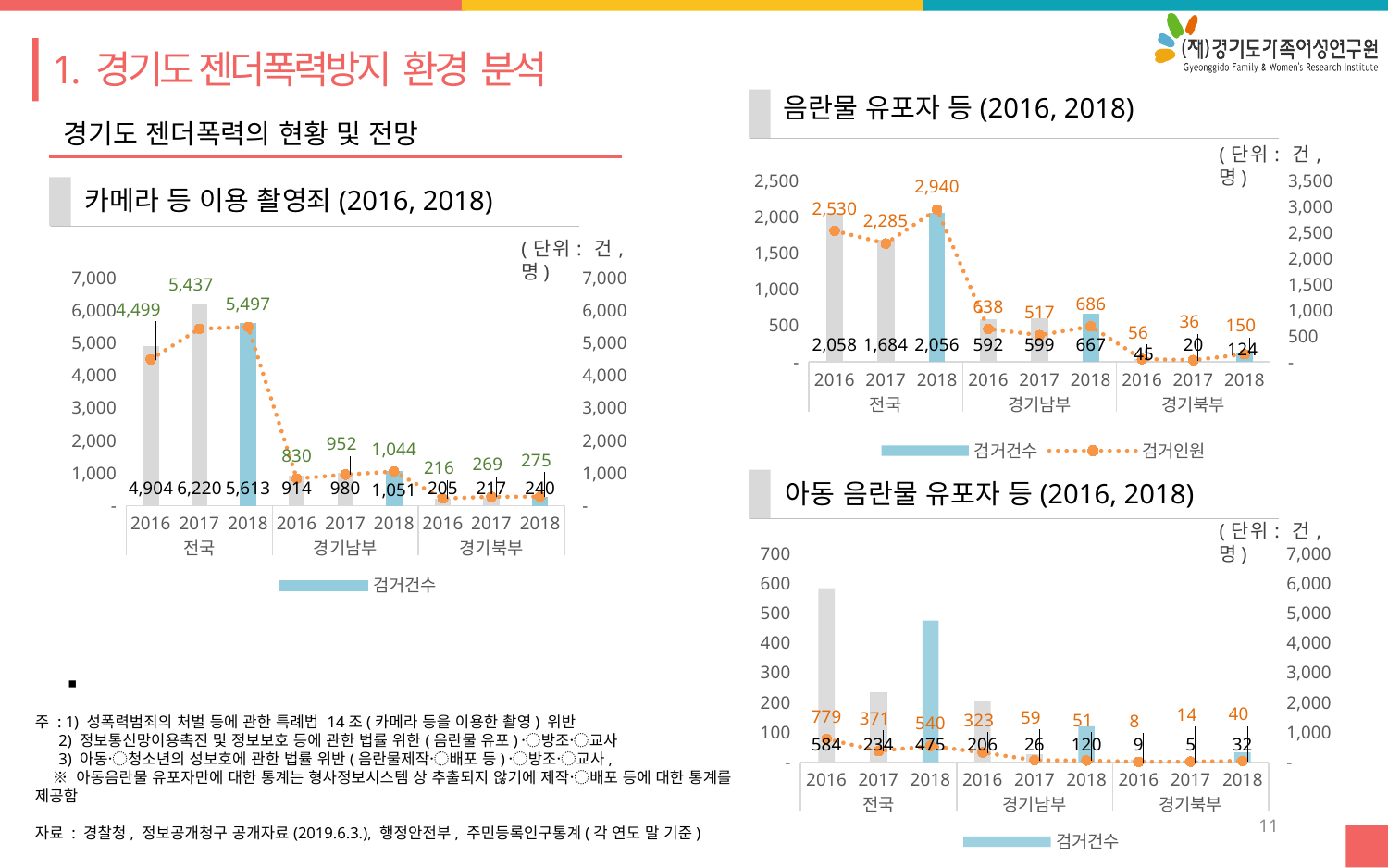
In the chart titled 음란물 유포자 등 (2016, 2018), how many series does the legend list? 2 In the chart titled 카메라 등 이용 촬영죄 (2016, 2018), which year has the highest 검거건수 bar for 전국? 2017 What kind of chart is the chart titled 아동 음란물 유포자 등 (2016, 2018)? Combined bar and line chart In the chart titled 카메라 등 이용 촬영죄 (2016, 2018), what is the 검거건수 bar value for 전국 in 2017? 6,220 In the chart titled 카메라 등 이용 촬영죄 (2016, 2018), what is the 검거건수 bar value for 경기북부 in 2018? 240 In the chart titled 카메라 등 이용 촬영죄 (2016, 2018), what is the difference between the 경기남부 검거건수 bars for 2018 and 2016? 137 In the chart titled 음란물 유포자 등 (2016, 2018), which is larger, the 검거건수 bar for 전국 in 2016 or for 전국 in 2017? 전국 2016 In the chart titled 아동 음란물 유포자 등 (2016, 2018), what is the difference between the 전국 검거건수 bars for 2016 and 2017? 350 In the chart titled 아동 음란물 유포자 등 (2016, 2018), which year has the lowest 검거건수 bar for 경기북부? 2017 In the chart titled 아동 음란물 유포자 등 (2016, 2018), what is the 검거건수 bar value for 전국 in 2016? 584 In the chart titled 음란물 유포자 등 (2016, 2018), what is the 검거건수 bar value for 경기북부 in 2017? 20 In the chart titled 음란물 유포자 등 (2016, 2018), what is the 검거인원 value for 전국 in 2018? 2,940